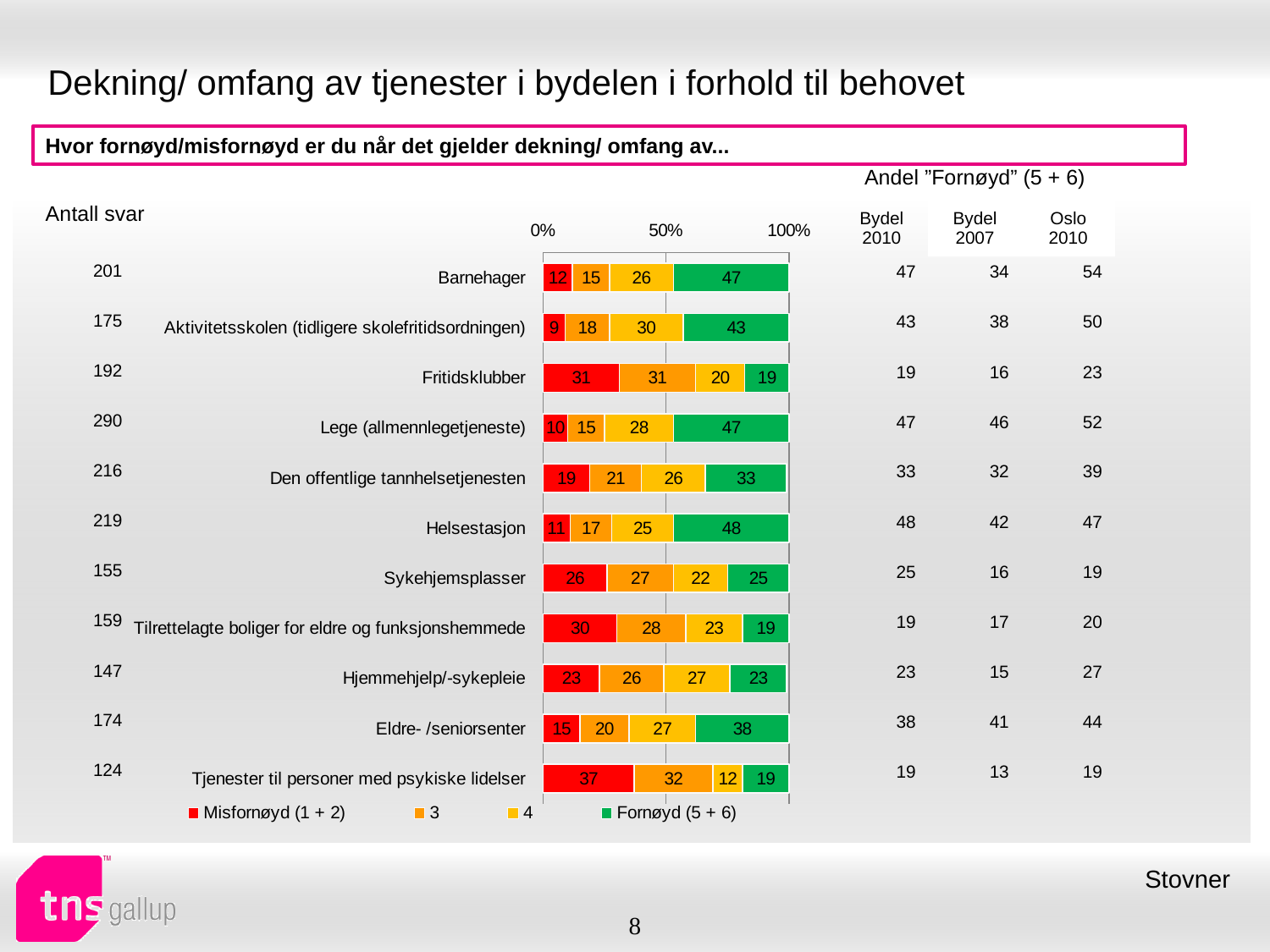
What is the total of the stacked bar for Barnehager? 100 What is the value of series 4 for Hjemmehjelp/-sykepleie? 27 What type of chart is shown on the slide? Stacked bar chart What is the difference between the Fornøyd (5 + 6) values for Eldre-/seniorsenter and Sykehjemsplasser? 13 Which category has the highest Fornøyd (5 + 6) value? Helsestasjon What is the Misfornøyd (1 + 2) value for Fritidsklubber? 31 What is the Fornøyd (5 + 6) value for Barnehager? 47 Which category has the highest Misfornøyd (1 + 2) value? Tjenester til personer med psykiske lidelser How many series does the chart legend list? 4 How many categories (services) are plotted in the chart? 11 Which category has the lowest Misfornøyd (1 + 2) value? Aktivitetsskolen (tidligere skolefritidsordningen) Which is larger: the Fornøyd (5 + 6) value for Lege (allmennlegetjeneste) or for Den offentlige tannhelsetjenesten? Lege (allmennlegetjeneste)